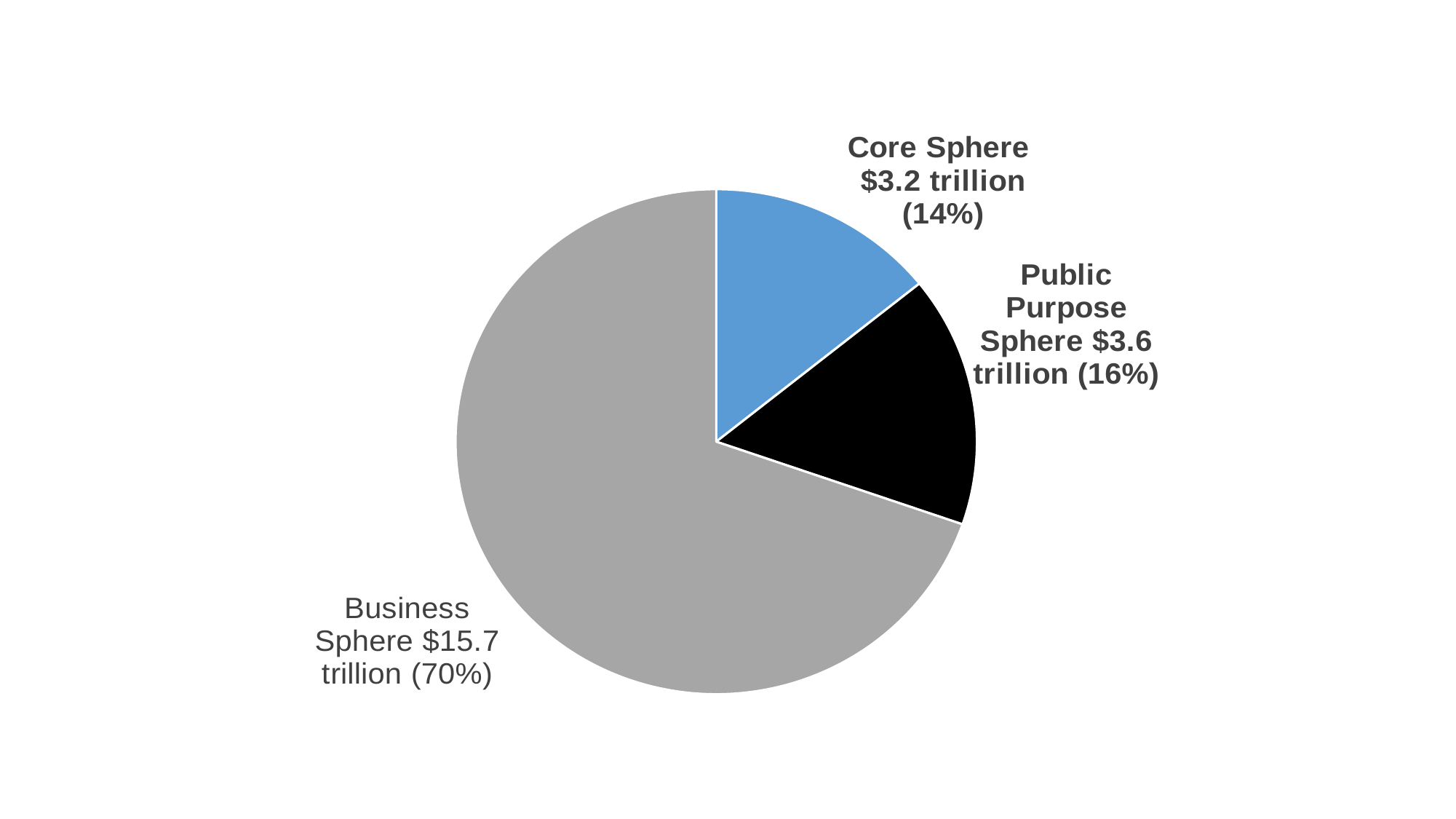
What share of the pie does the Public Purpose Sphere slice represent? 16% What is the value for the Public Purpose Sphere slice? $3.6 trillion What share of the pie does the Business Sphere slice represent? 70% What kind of chart is shown on the slide? pie chart What is the difference in value between the Business Sphere and the Public Purpose Sphere? $12.1 trillion What share of the pie does the Core Sphere slice represent? 14% How many slices does the pie chart have? 3 Which slice is the smallest? Core Sphere Which slice is the largest? Business Sphere What is the value for the Business Sphere slice? $15.7 trillion What colour is the Core Sphere slice? blue What is the value for the Core Sphere slice? $3.2 trillion